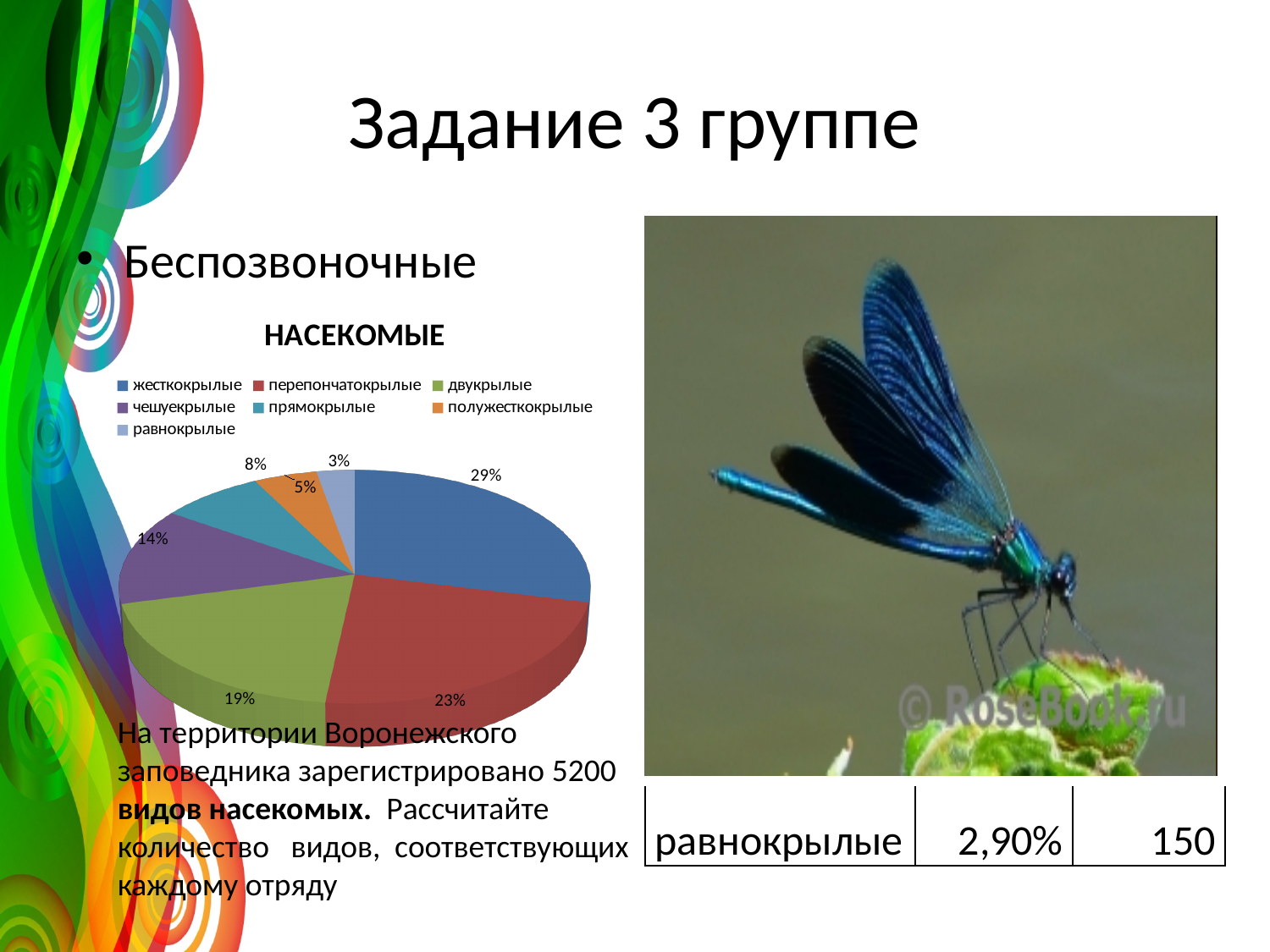
What share of the pie does чешуекрылые have? 14% Which has a larger share, прямокрылые or полужесткокрылые? прямокрылые What share of the pie does жесткокрылые have? 29% How many categories does the legend of the pie chart list? 7 What share of the pie does равнокрылые have? 3% Which category has the largest slice of the pie? жесткокрылые What is the title of the pie chart? НАСЕКОМЫЕ What is the difference in percentage points between жесткокрылые and перепончатокрылые? 6% What kind of chart is shown on the slide? pie chart Which category has the smallest slice of the pie? равнокрылые